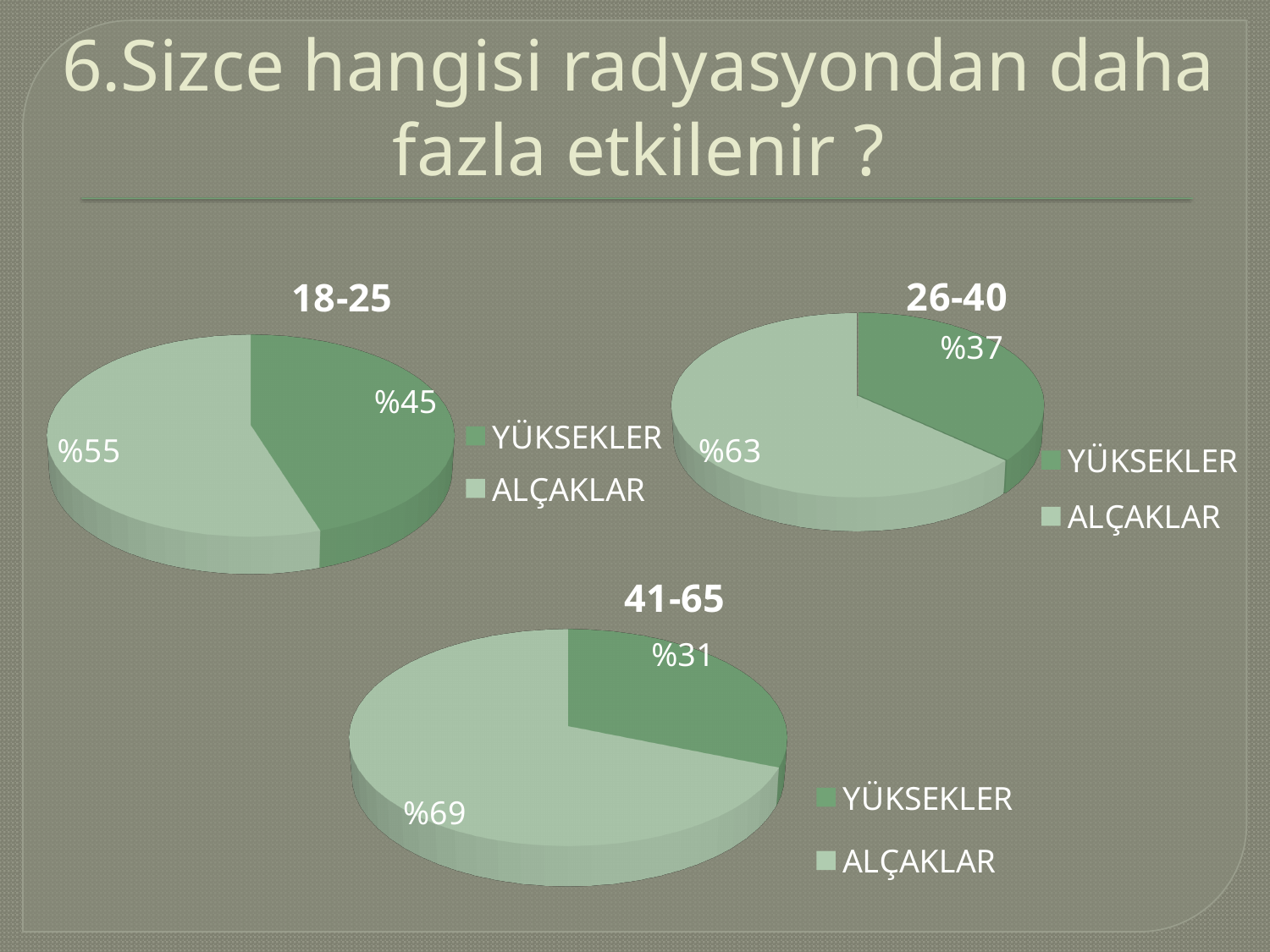
In the 41-65 chart, which slice is the largest? ALÇAKLAR In the 41-65 chart, what is the value for YÜKSEKLER? %31 In the 41-65 chart, what is the value for ALÇAKLAR? %69 In the 18-25 chart, what is the difference between ALÇAKLAR and YÜKSEKLER? %10 In the 18-25 chart, what is the value for YÜKSEKLER? %45 In the 26-40 chart, what is the value for ALÇAKLAR? %63 In the 41-65 chart, which is larger, YÜKSEKLER or ALÇAKLAR? ALÇAKLAR In the 18-25 chart, what is the value for ALÇAKLAR? %55 In the 26-40 chart, what is the value for YÜKSEKLER? %37 In the 26-40 chart, which slice is the smallest? YÜKSEKLER How many entries does the legend of the 18-25 chart list? 2 What kind of chart is the 26-40 chart? Pie chart